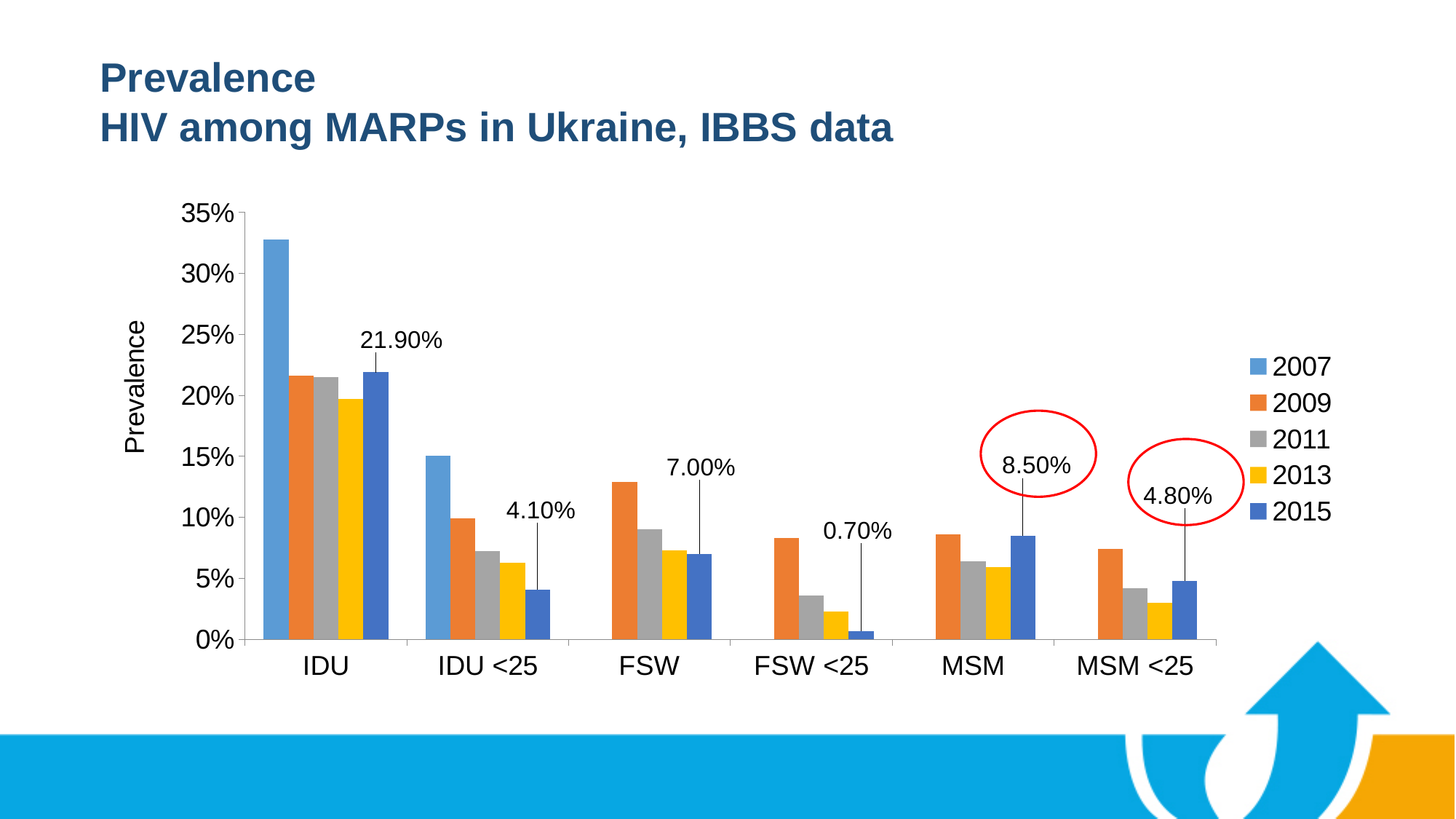
What is the difference between the 2015 values for IDU and IDU <25? 17.80% What is the 2015 value shown for FSW <25? 0.70% What kind of chart is shown on the slide? bar chart Which has the larger 2015 value, MSM or FSW? MSM What is the 2015 value shown for MSM <25? 4.80% How many series does the legend list? 5 Which category has the highest 2015 value? IDU Which category has the lowest 2015 value? FSW <25 What is the 2015 value shown for MSM? 8.50% What is the 2015 HIV prevalence value shown for IDU? 21.90% How many categories are shown on the x axis? 6 Is the 2007 value for IDU greater or less than 30%? greater